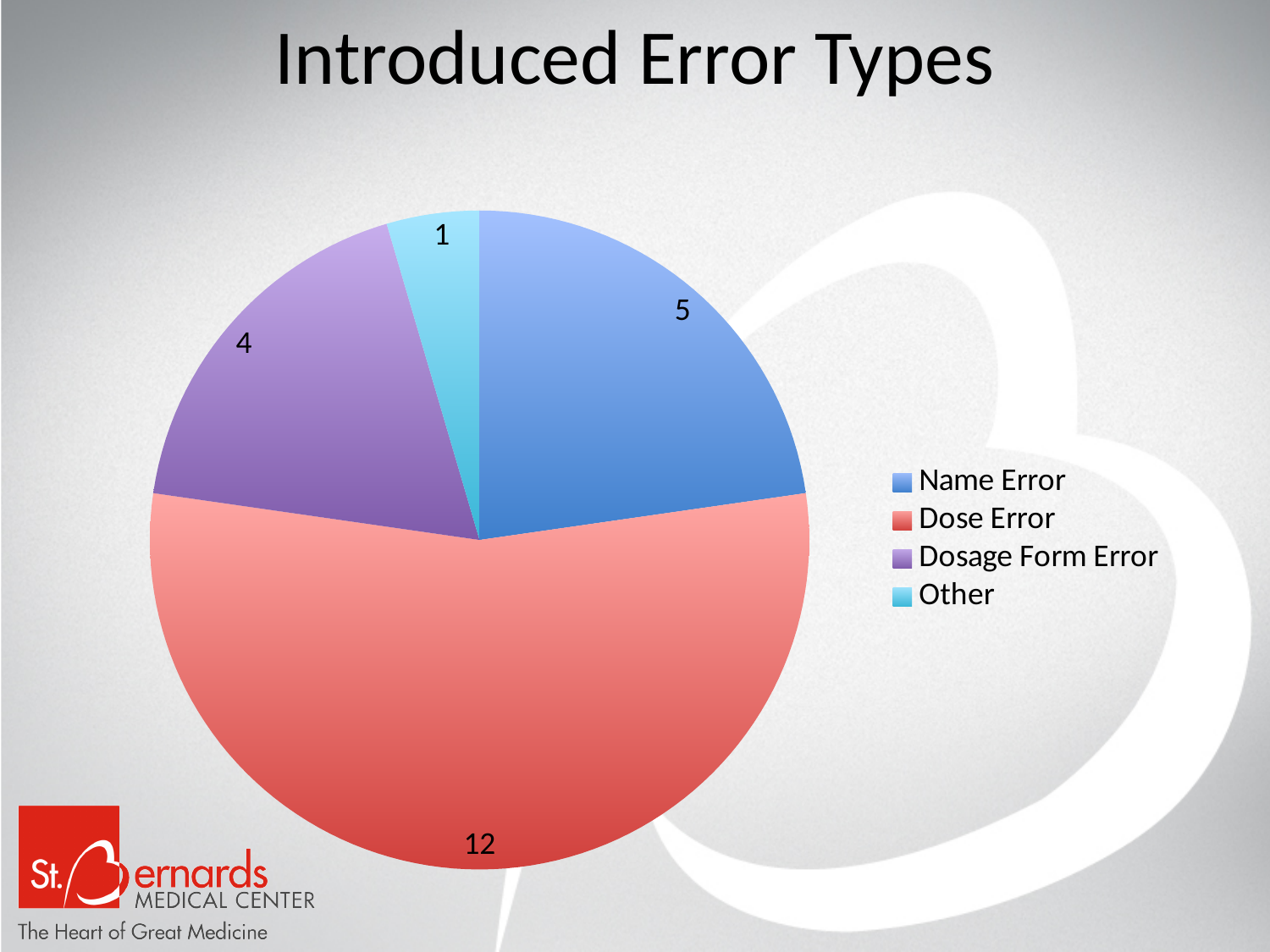
What is the value for Dosage Form Error? 4 What is the difference between the Dose Error value and the Name Error value? 7 Which error type has the largest slice? Dose Error What is the title of the chart? Introduced Error Types What is the value for Name Error? 5 Which is larger, Name Error or Dosage Form Error? Name Error Which error type has the smallest slice? Other What is the value for Other? 1 What is the total of all slices in the pie? 22 How many categories does the legend list? 4 What type of chart is shown on the slide? pie chart What is the value for Dose Error? 12